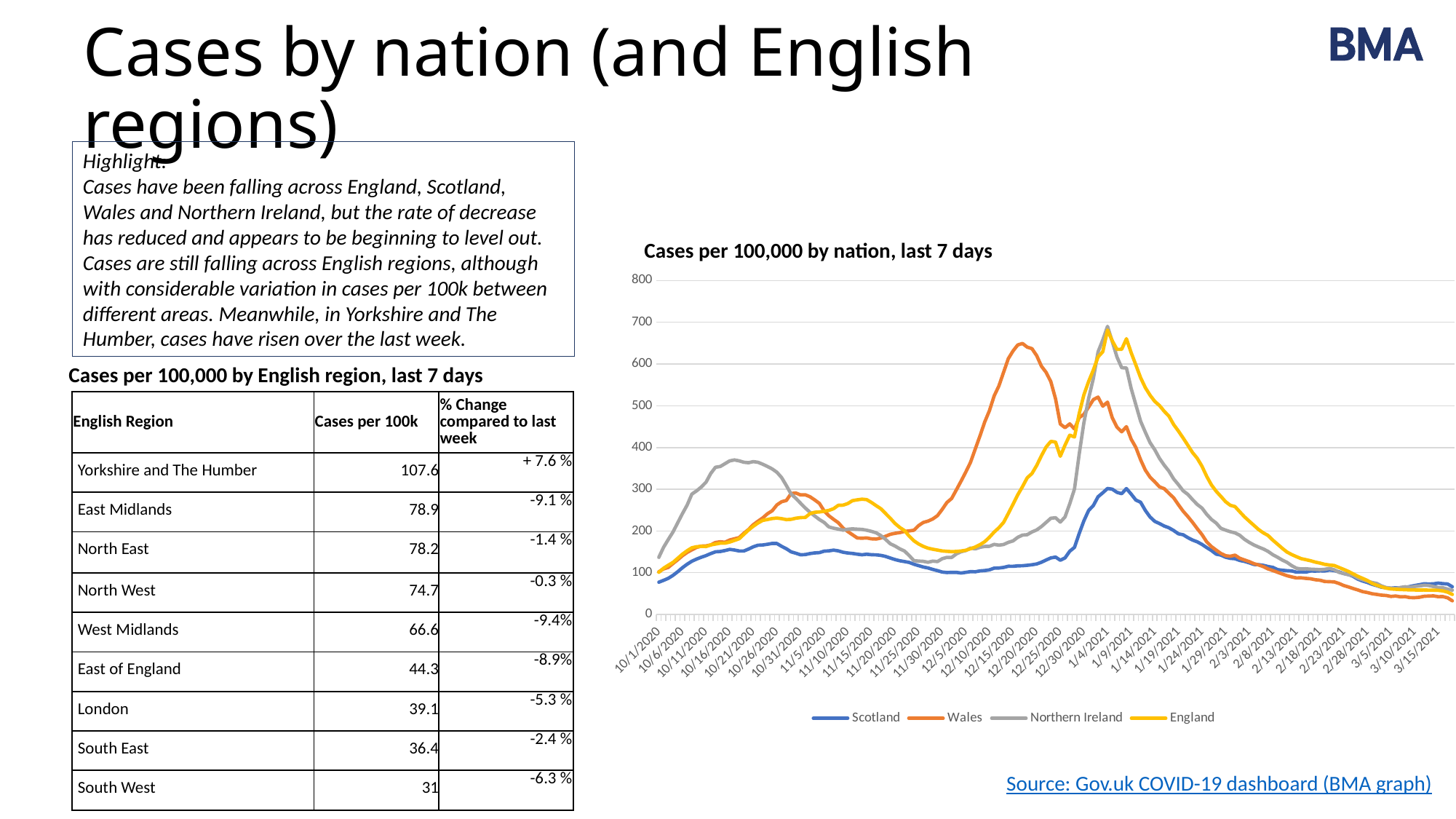
Which nation's line has the lowest peak over the whole period shown? Scotland What kind of chart is 'Cases per 100,000 by nation, last 7 days'? line chart What is the title of the chart on the slide? Cases per 100,000 by nation, last 7 days Is the value for Northern Ireland around 10/21/2020 greater or less than 300? greater Around 10/21/2020, which is larger: the value for Northern Ireland or the value for England? Northern Ireland Which nations are listed in the chart's legend? Scotland, Wales, Northern Ireland, England From 1/9/2021 to 3/15/2021, do the values for England rise or fall? fall Is the peak value for Scotland around 1/4/2021 greater or less than 400? less How many series does the legend of the chart list? 4 Around 12/20/2020, which is larger: the value for Wales or the value for Scotland? Wales Is the value for Wales around 12/20/2020 greater or less than 600? greater